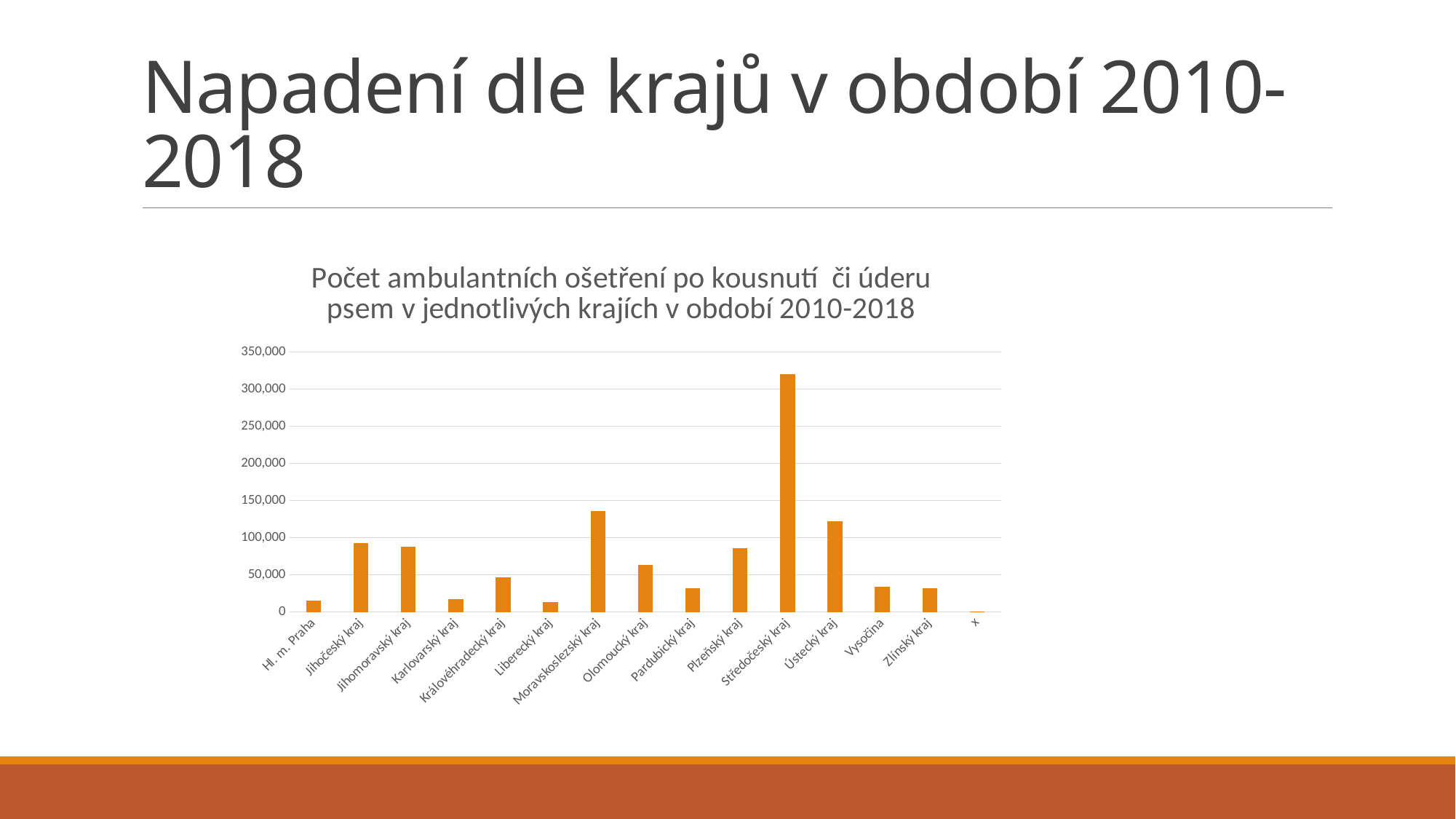
Is the value for Karlovarský kraj greater or less than 50,000? less Which has a higher value, Moravskoslezský kraj or Ústecký kraj? Moravskoslezský kraj Which has a higher value, Plzeňský kraj or Olomoucký kraj? Plzeňský kraj Is the value for Vysočina greater or less than 50,000? less Which has a higher value, Královéhradecký kraj or Liberecký kraj? Královéhradecký kraj Is the value for Plzeňský kraj greater or less than 50,000? greater What is the title of the chart? Počet ambulantních ošetření po kousnutí či úderu psem v jednotlivých krajích v období 2010-2018 What kind of chart is shown on the slide? bar chart How many categories are shown on the x axis of the chart? 15 Which region has the highest number of outpatient treatments in the chart? Středočeský kraj